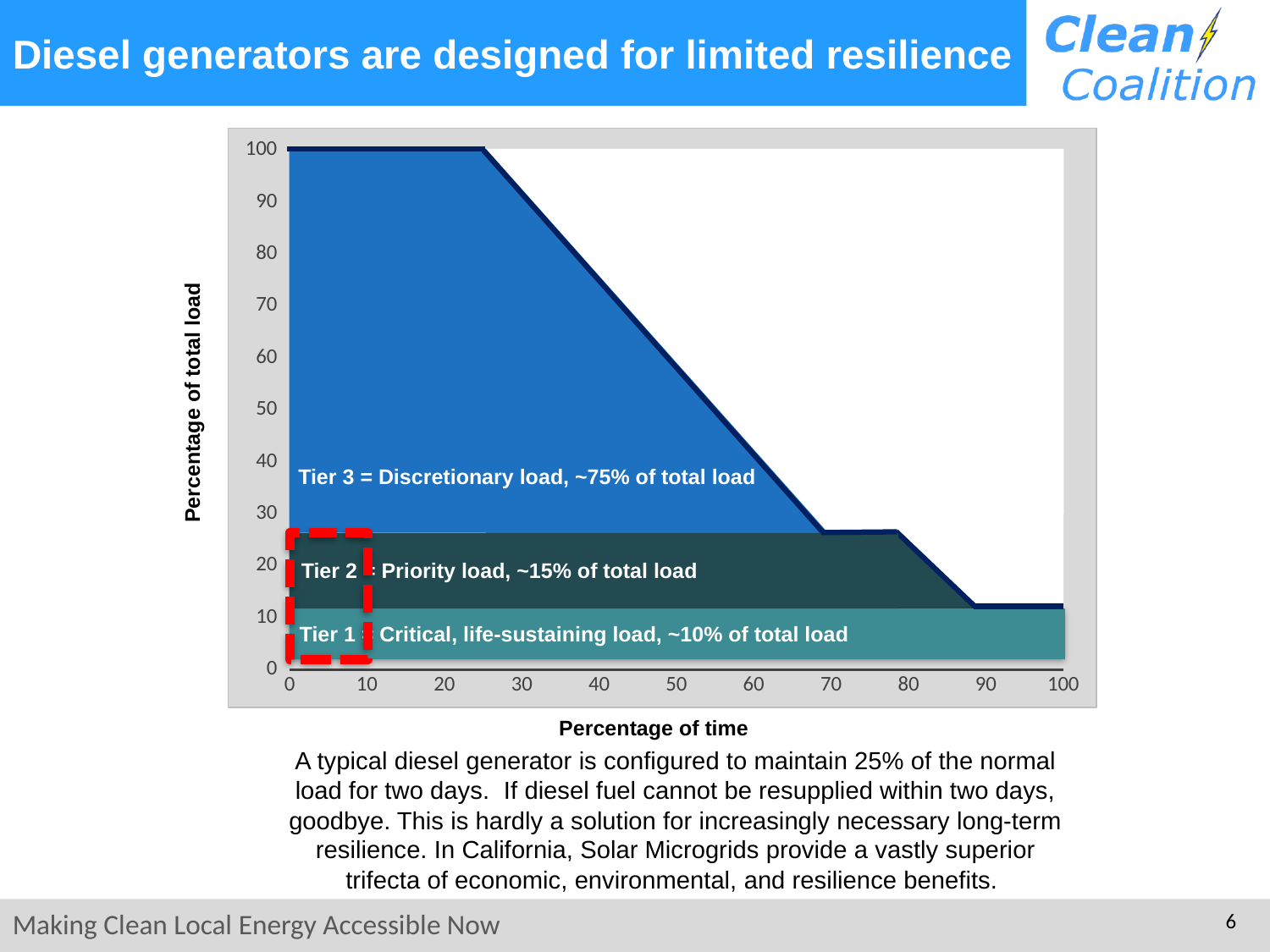
Does the percentage of total load rise or fall as the percentage of time increases? fall What is the percentage of total load at 10% of time? 100 According to the chart annotation, what share of total load is Tier 1, the critical, life-sustaining load? ~10% Which is larger, the percentage of total load at 10% of time or at 90% of time? 10% of time What is the title of the x axis of the chart? Percentage of time According to the chart annotation, what share of total load is Tier 3, the discretionary load? ~75% Is the percentage of total load at 95% of time greater or less than 20? less What is the title of the y axis of the chart? Percentage of total load What kind of chart is shown on the slide? area chart Is the percentage of total load at 50% of time greater or less than 40? greater Is the percentage of total load at 40% of time greater or less than 60? greater What is the percentage of total load at 0% of time? 100